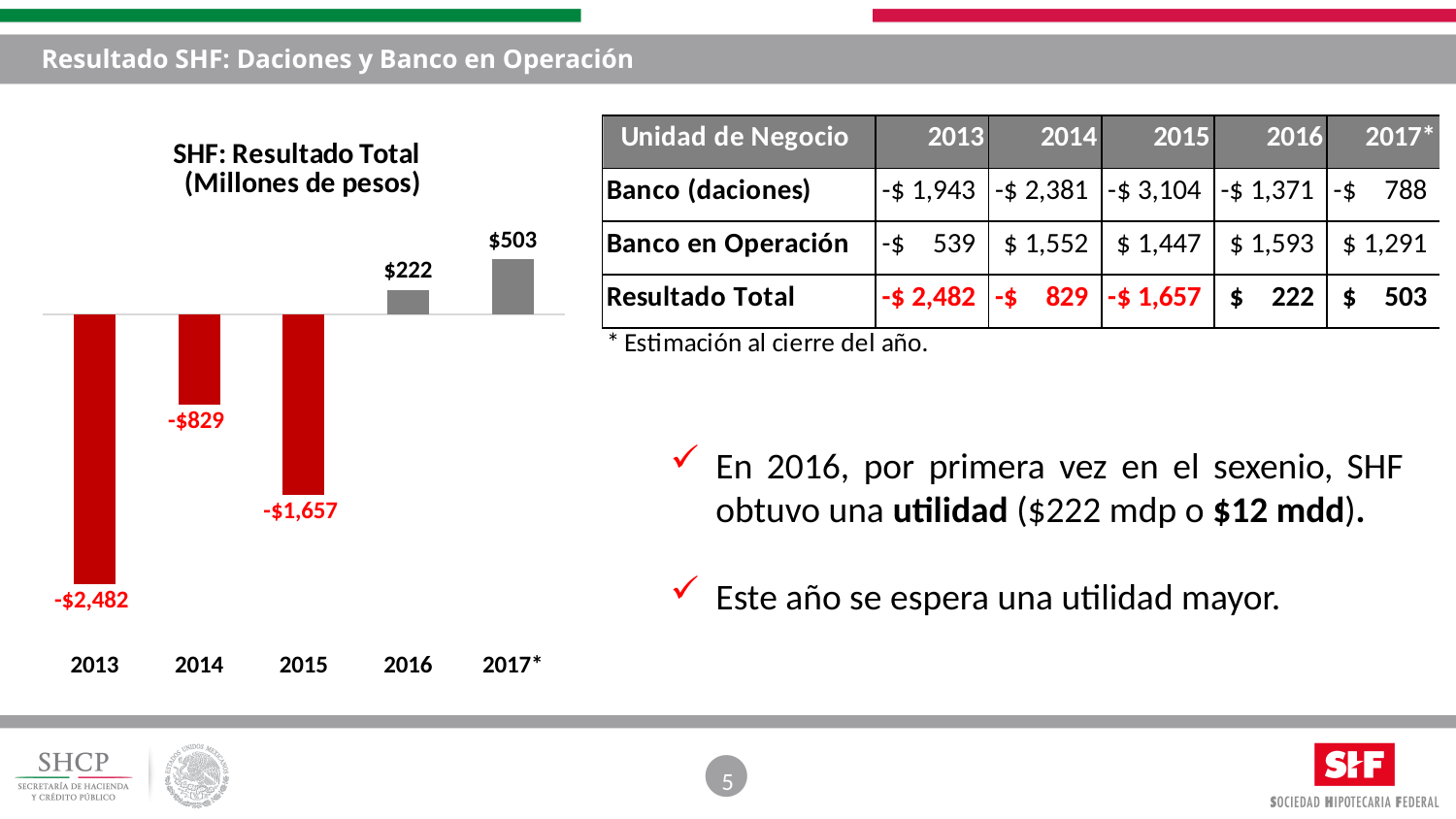
Which year has the highest value in the SHF: Resultado Total chart? 2017* What is the value for 2017* in the SHF: Resultado Total chart? $503 What is the value for 2015 in the SHF: Resultado Total chart? -$1,657 What is the value for 2016 in the SHF: Resultado Total chart? $222 Which year has the lowest value in the SHF: Resultado Total chart? 2013 How many years are shown in the SHF: Resultado Total chart? 5 What is the difference between the 2017* and 2016 values in the SHF: Resultado Total chart? $281 What kind of chart is the SHF: Resultado Total chart? Bar chart What is the value for 2013 in the SHF: Resultado Total chart? -$2,482 Which is larger in the SHF: Resultado Total chart, the value for 2014 or the value for 2015? 2014 What unit is given in the subtitle of the SHF: Resultado Total chart? Millones de pesos Do the values in the SHF: Resultado Total chart rise or fall from 2015 to 2017*? Rise